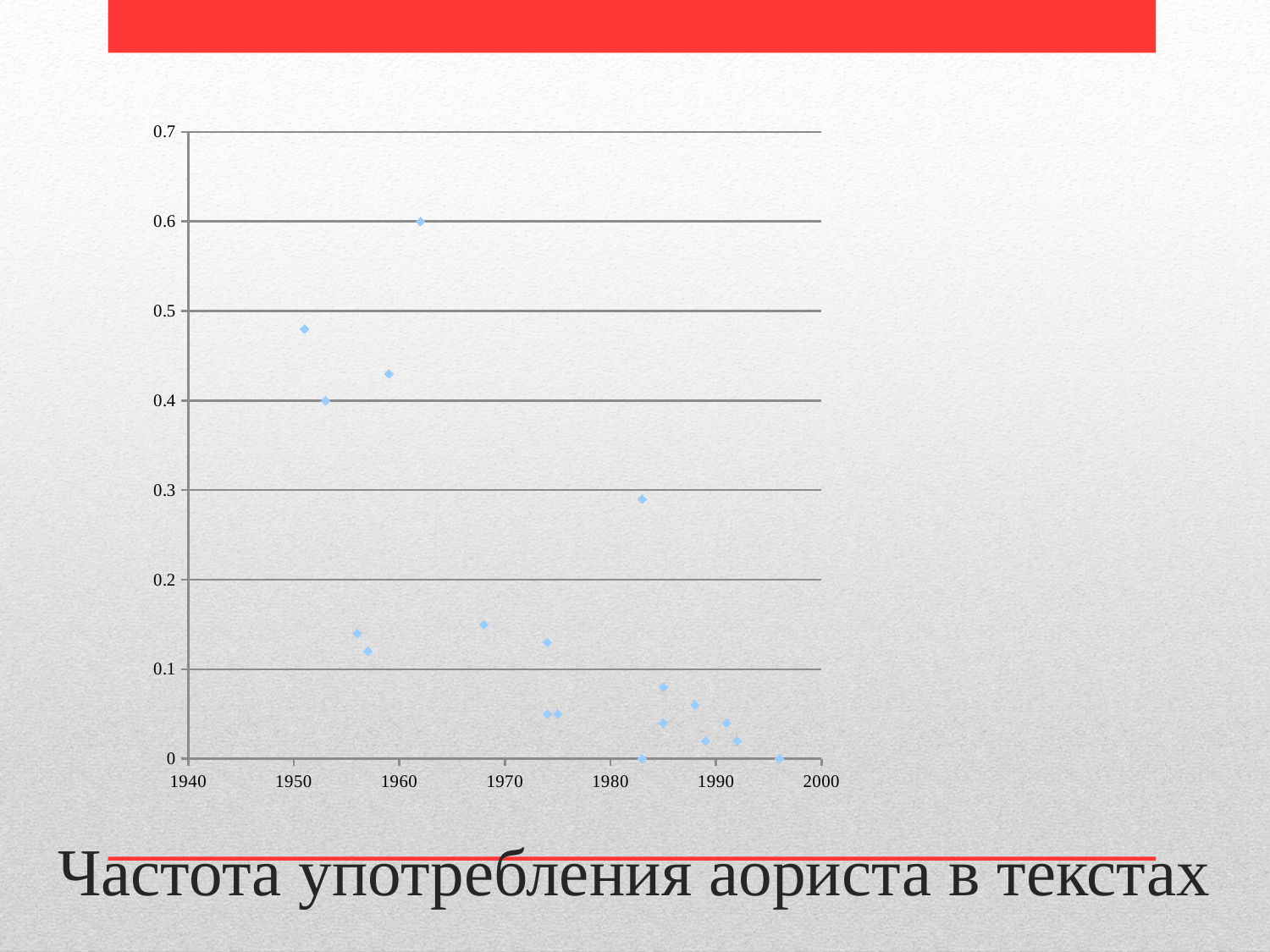
Is the value of the highest point plotted after 1980 greater or less than 0.2? greater Do the plotted values generally rise or fall as the years increase along the x axis? fall What is the maximum value shown on the vertical axis? 0.7 Is the value of the point plotted between 1960 and 1970 that lies closest to 1970 greater or less than 0.2? less Are all the points plotted after 1985 greater or less than 0.1? less Which is larger: the highest value plotted before 1970 or the highest value plotted after 1970? the highest value before 1970 What kind of chart is shown on the slide? scatter chart What is the title of the chart on the slide? Частота употребления аориста в текстах